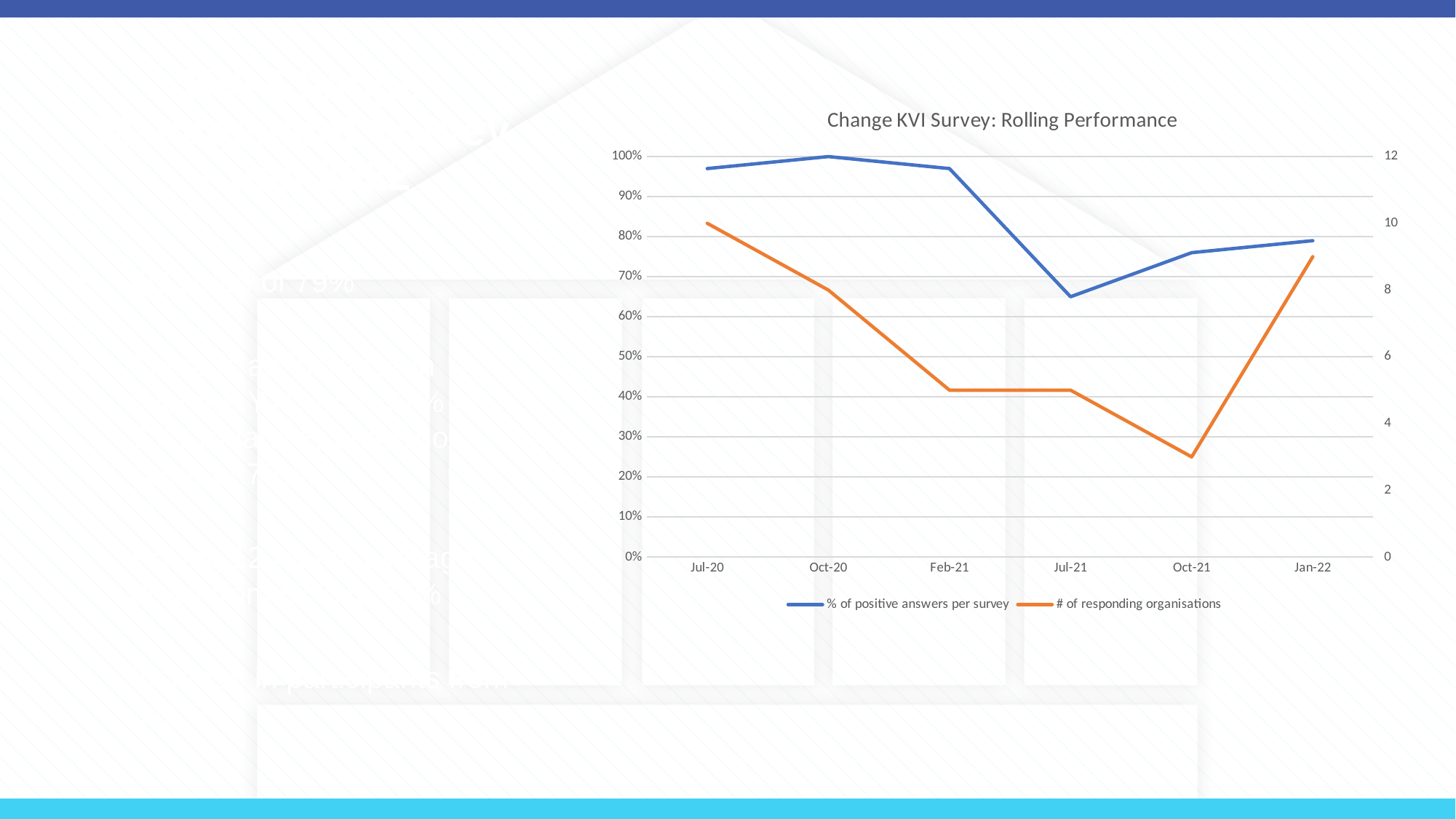
How many series does the legend list? 2 How many survey dates are plotted along the x axis? 6 What is the title of the chart? Change KVI Survey: Rolling Performance What kind of chart is shown on the slide? line chart What is the # of responding organisations for Oct-20? 8 What is the # of responding organisations for Jul-20? 10 Is the % of positive answers per survey for Jul-21 greater or less than 70%? less At which survey date is the % of positive answers per survey lowest? Jul-21 What is the % of positive answers per survey for Oct-20? 100% At which survey date is the # of responding organisations lowest? Oct-21 Does the # of responding organisations rise or fall from Jul-20 to Oct-21? fall Is the # of responding organisations for Jan-22 greater or less than 8? greater